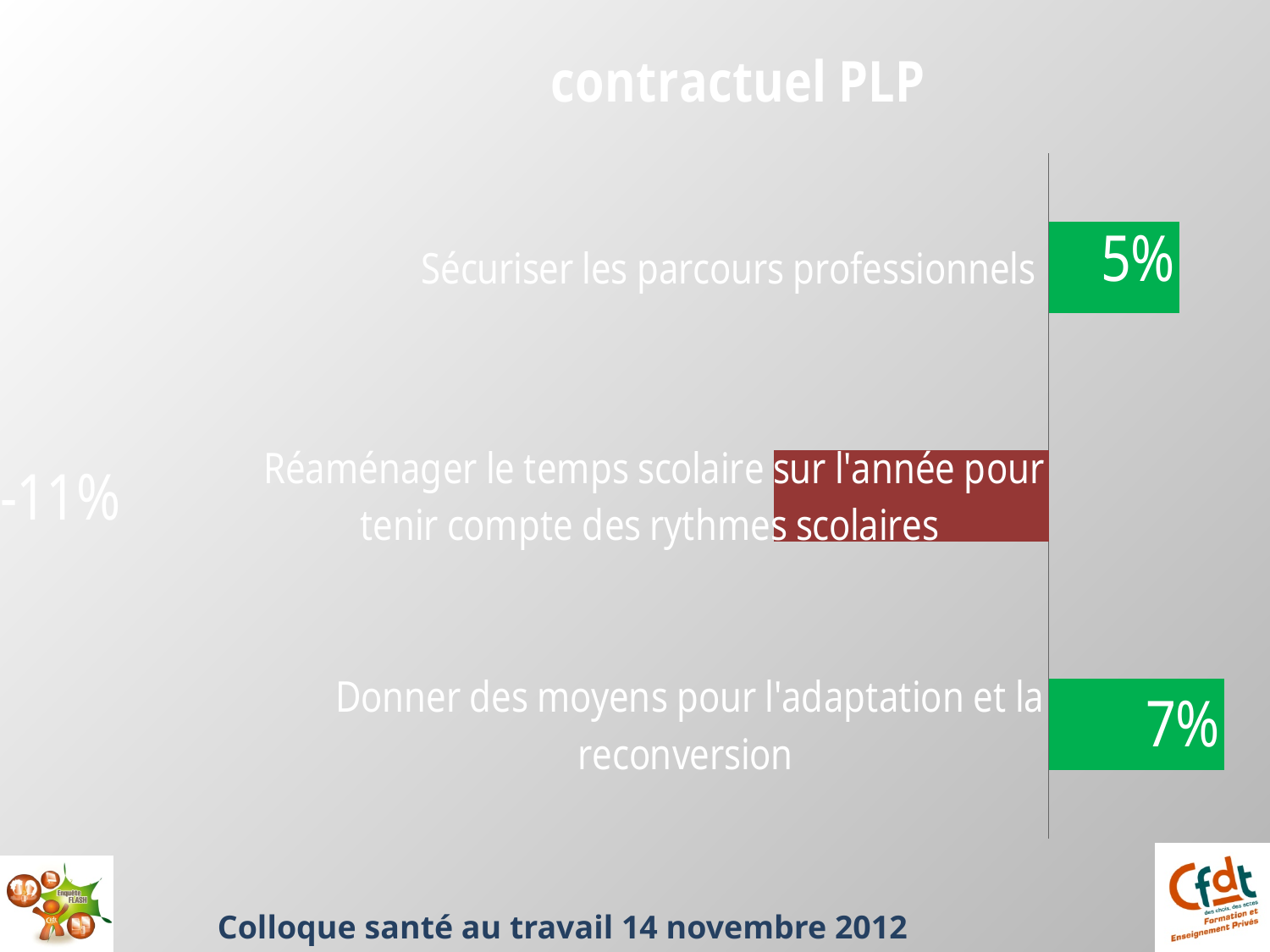
What is the value for "Sécuriser les parcours professionnels"? 5% Which category has the lowest value? Réaménager le temps scolaire sur l'année pour tenir compte des rythmes scolaires Which is larger: the value for "Sécuriser les parcours professionnels" or the value for "Donner des moyens pour l'adaptation et la reconversion"? Donner des moyens pour l'adaptation et la reconversion What is the value for "Réaménager le temps scolaire sur l'année pour tenir compte des rythmes scolaires"? -11% What is the difference between the values for "Donner des moyens pour l'adaptation et la reconversion" and "Sécuriser les parcours professionnels"? 2% What kind of chart is shown on the slide? Bar chart What is the value for "Donner des moyens pour l'adaptation et la reconversion"? 7% What colour is the bar for the category with a negative value? Red What is the title of the chart? contractuel PLP How many categories have a negative value? 1 Which category has the highest value? Donner des moyens pour l'adaptation et la reconversion How many categories does the chart show? 3